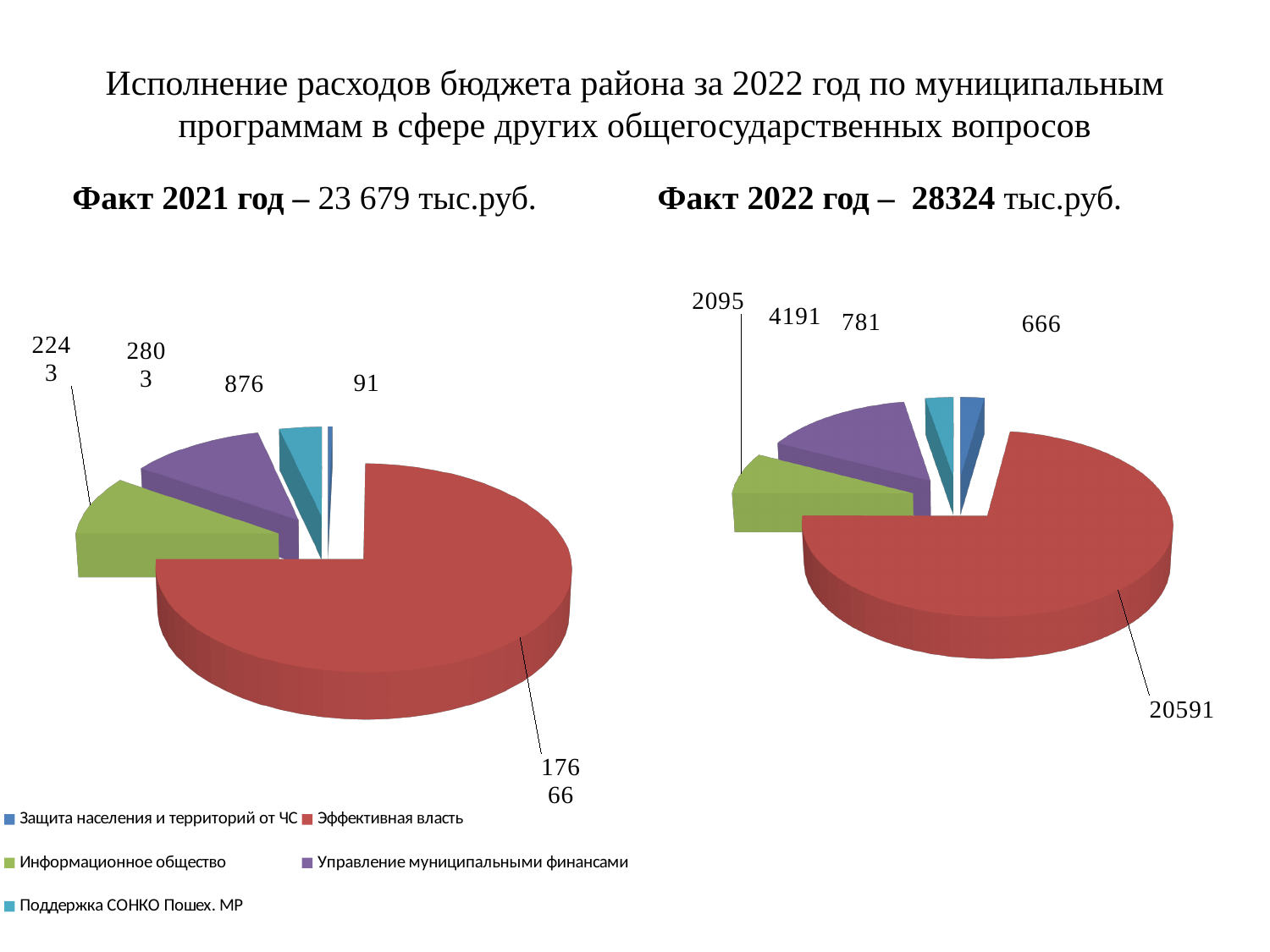
How many categories does the legend list? 5 In the 2022 pie chart (right), which is larger: Информационное общество or Управление муниципальными финансами? Управление муниципальными финансами In the 2021 pie chart (left), what is the value for Поддержка СОНКО Пошех. МР? 876 In the 2022 pie chart (right), what is the value for Управление муниципальными финансами? 4191 In the 2022 pie chart (right), what is the value for Эффективная власть? 20591 In the 2022 pie chart (right), which category has the largest value? Эффективная власть In the 2022 pie chart (right), what is the value for Защита населения и территорий от ЧС? 666 In the 2021 pie chart (left), which category has the smallest value? Защита населения и территорий от ЧС What is the difference between the Эффективная власть values in the 2022 chart and the 2021 chart? 2925 Which colour represents Информационное общество in the legend? Green In the 2021 pie chart (left), what is the value for Эффективная власть? 17666 What type of chart is used on this slide? Pie chart